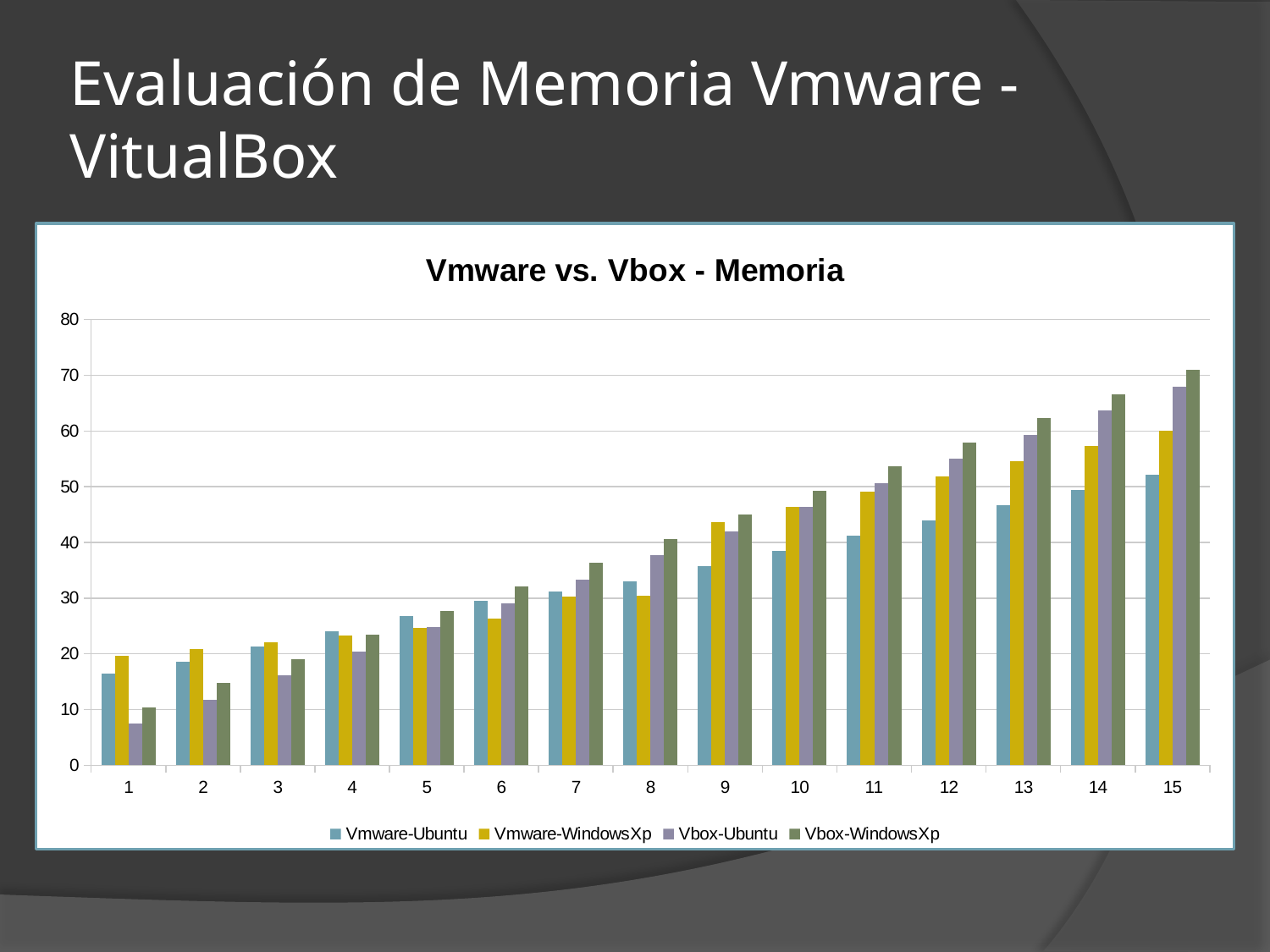
At category 1, which is larger: Vmware-WindowsXp or Vbox-Ubuntu? Vmware-WindowsXp How many series does the chart's legend list? 4 Do the values for Vbox-WindowsXp rise or fall from category 1 to category 15? rise What kind of chart is shown on the slide? bar chart Is the value for Vbox-Ubuntu at category 1 greater or less than 10? less At category 10, which is larger: Vbox-WindowsXp or Vmware-Ubuntu? Vbox-WindowsXp What is the title of the chart? Vmware vs. Vbox - Memoria How many categories are shown along the x axis of the chart? 15 At category 1, which series has the lowest value? Vbox-Ubuntu At category 15, which series has the highest value? Vbox-WindowsXp Is the value for Vmware-Ubuntu at category 15 greater or less than 60? less Is the value for Vbox-WindowsXp at category 15 greater or less than 60? greater